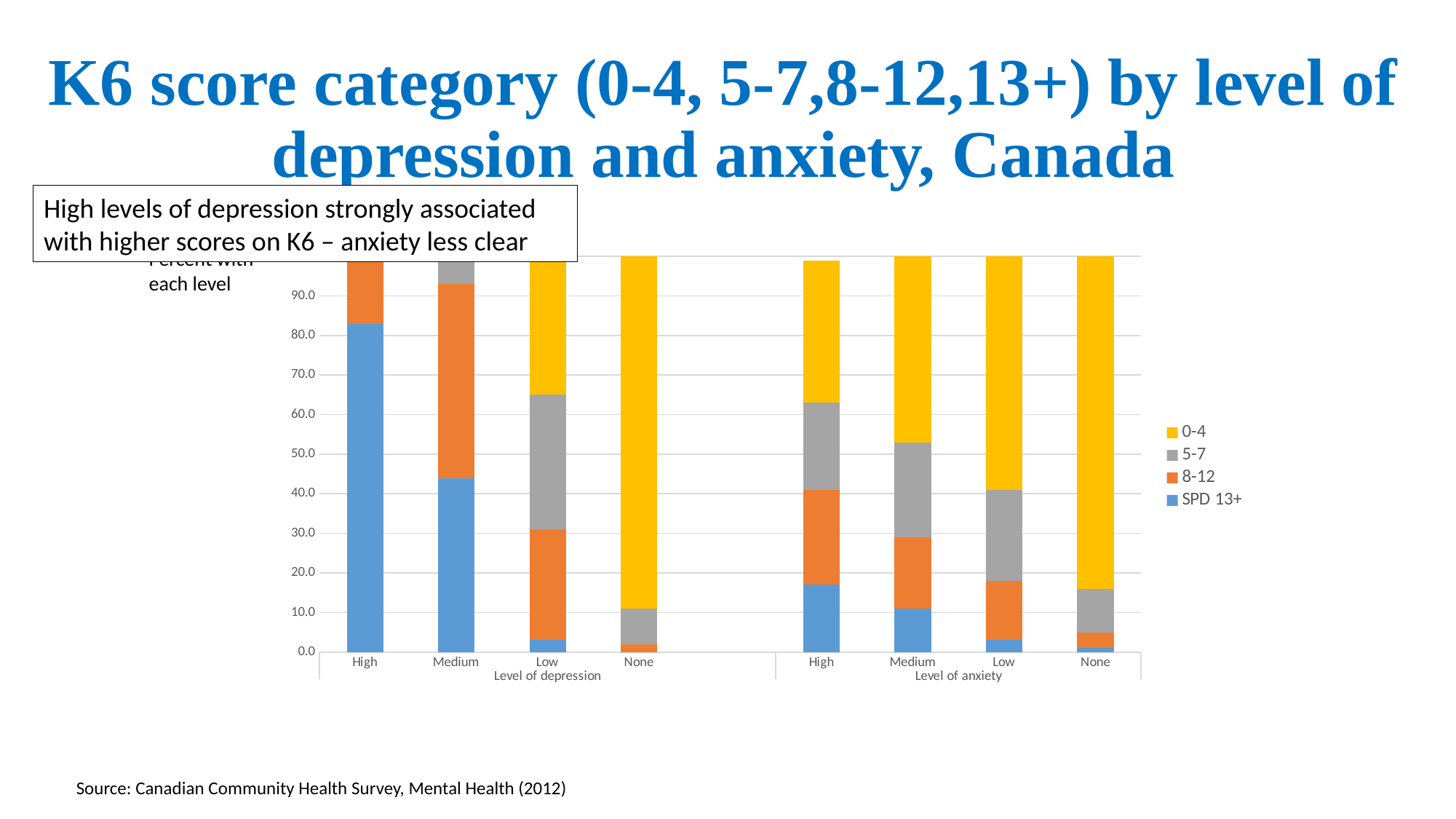
What are the two groups labelled on the x axis? Level of depression and Level of anxiety How many series does the legend list? 4 Is the SPD 13+ value for Low level of depression greater or less than 10? less How many bars are plotted in the chart? 8 Is the SPD 13+ value for Low level of anxiety greater or less than 10? less Which category has the largest SPD 13+ segment? High level of depression Which has a larger SPD 13+ share: High level of depression or High level of anxiety? High level of depression Is the SPD 13+ value for Medium level of depression greater or less than 40? greater What kind of chart is shown on the slide? Stacked bar chart Which series is shown in blue in the legend? SPD 13+